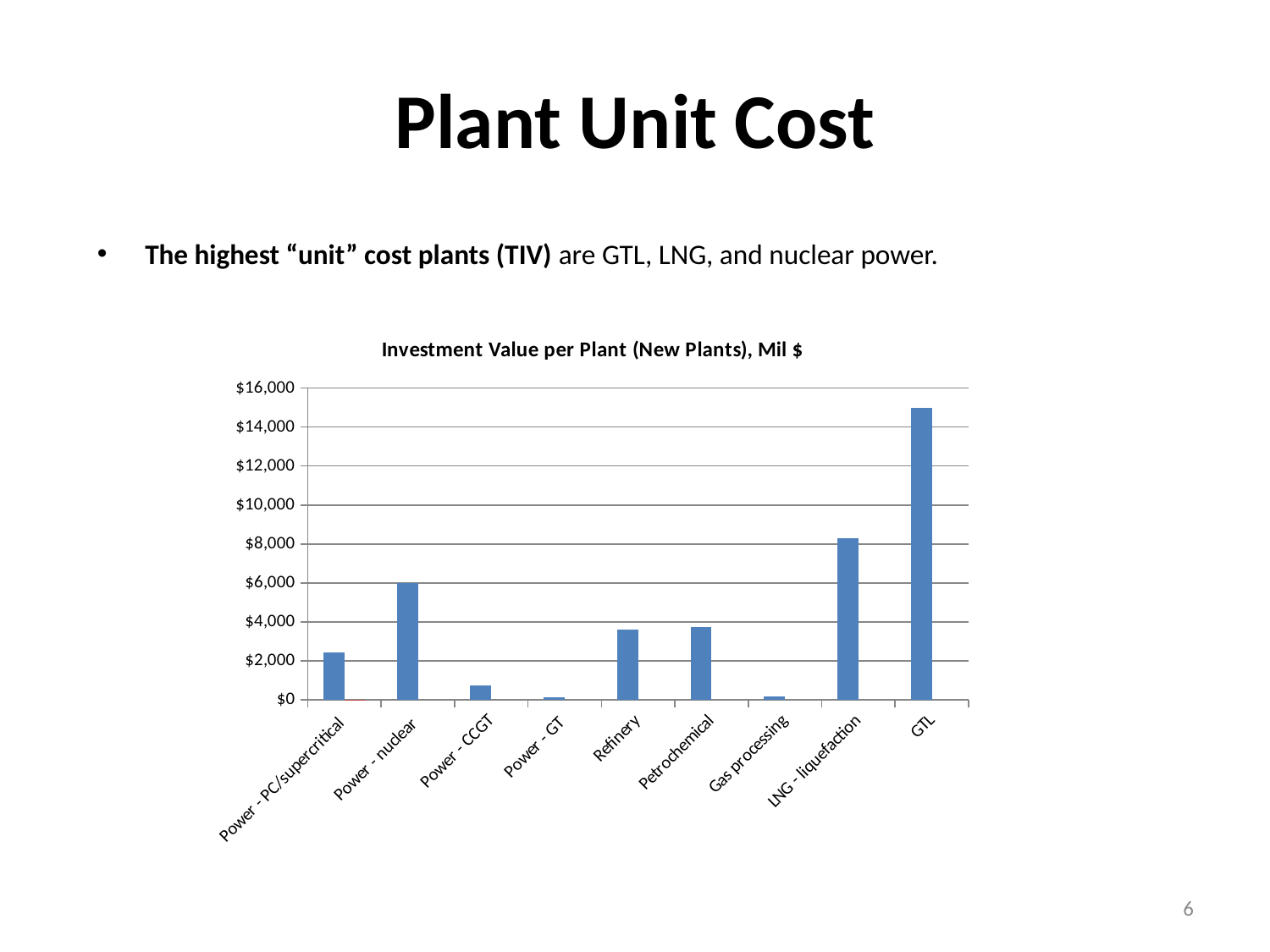
Is the value for Gas processing greater or less than $2,000? less How many plant categories are shown on the x axis of the chart? 9 Is the value for Power - CCGT greater or less than $2,000? less Which has a higher investment value per plant, Power - nuclear or Power - PC/supercritical? Power - nuclear Is the value for Refinery greater or less than $4,000? less Which has a higher investment value per plant, LNG - liquefaction or Power - nuclear? LNG - liquefaction What is the title of the chart? Investment Value per Plant (New Plants), Mil $ What type of chart is shown on the slide? Bar chart Which plant category has the highest investment value per plant? GTL